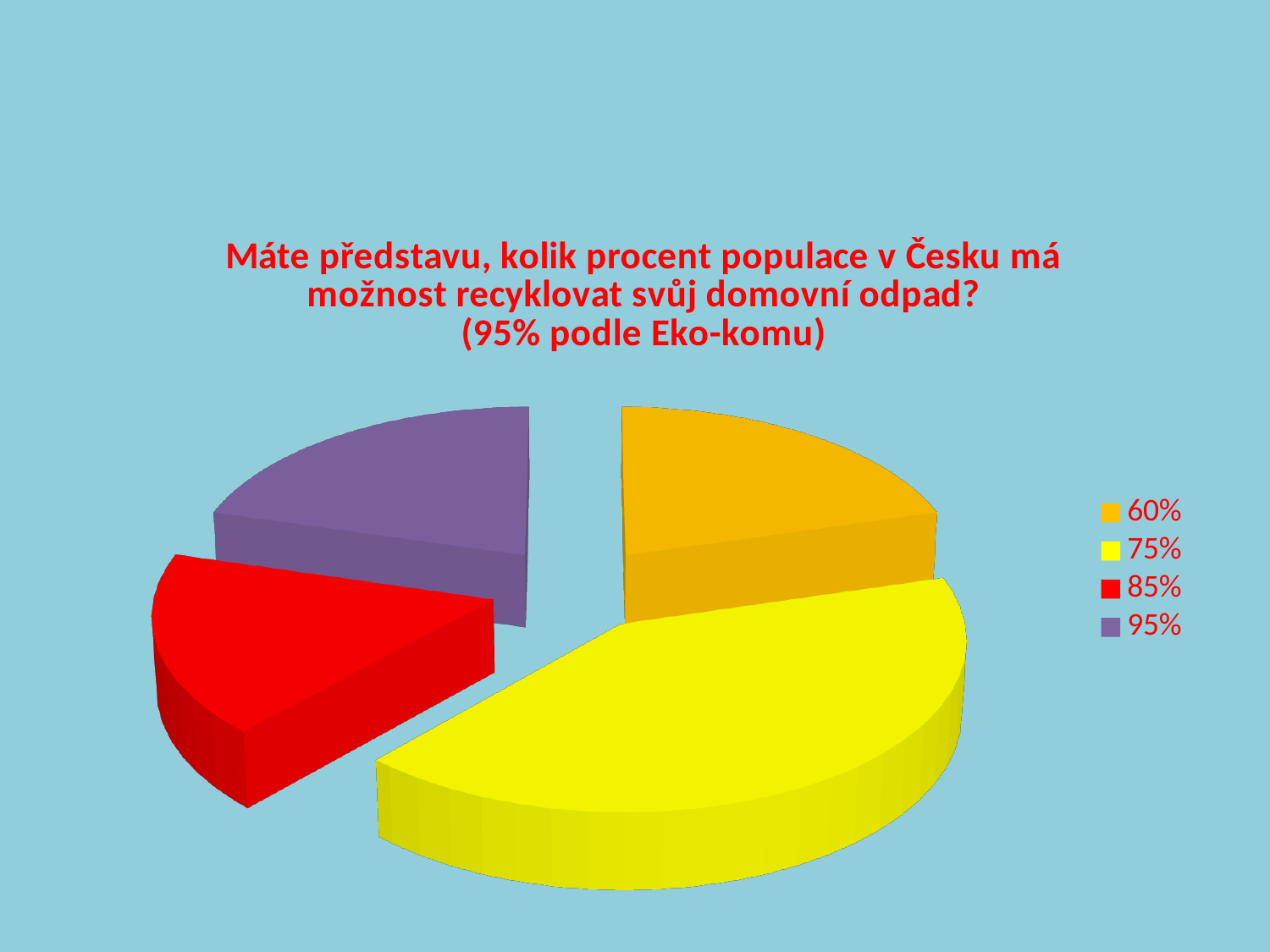
Which answer category has the largest slice of the pie chart? 75% How many entries does the legend list? 4 How many slices does the pie chart have? 4 Which answer category is shown in yellow in the legend? 75% What kind of chart is shown on the slide? pie chart Which slice is larger, the one for 75% or the one for 95%? 75% Which slice is larger, the one for 75% or the one for 60%? 75% What colour is the slice for the 95% answer? purple Which slice is larger, the one for 75% or the one for 85%? 75%